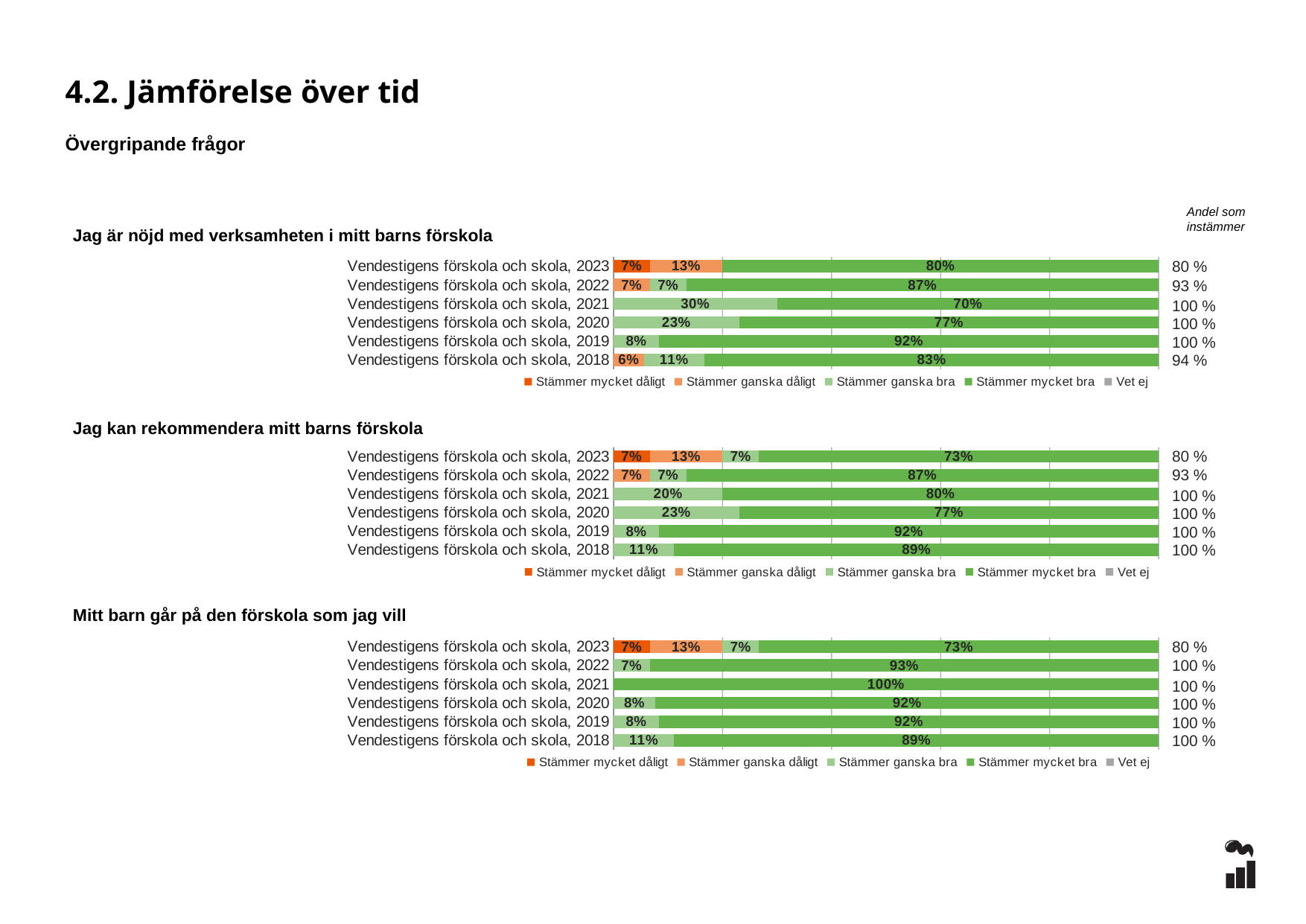
In the chart 'Jag är nöjd med verksamheten i mitt barns förskola', what is the 'Stämmer mycket bra' value for Vendestigens förskola och skola, 2023? 80% In the chart 'Mitt barn går på den förskola som jag vill', what is the 'Stämmer mycket bra' value for Vendestigens förskola och skola, 2021? 100% In the chart 'Jag kan rekommendera mitt barns förskola', what is the difference between the 'Stämmer mycket bra' values for 2019 and 2018? 3% In the chart 'Mitt barn går på den förskola som jag vill', is the 'Stämmer mycket bra' value for 2022 larger or smaller than the value for 2018? larger In the chart 'Jag är nöjd med verksamheten i mitt barns förskola', what is the 'Stämmer ganska bra' value for Vendestigens förskola och skola, 2021? 30% In the chart 'Jag kan rekommendera mitt barns förskola', what is the 'Stämmer mycket bra' value for Vendestigens förskola och skola, 2023? 73% In the chart 'Jag är nöjd med verksamheten i mitt barns förskola', what is the 'Andel som instämmer' value for 2018? 94 % What kind of chart is 'Jag kan rekommendera mitt barns förskola'? Stacked bar chart How many bars (years) are shown in the chart 'Jag är nöjd med verksamheten i mitt barns förskola'? 6 In the chart 'Jag kan rekommendera mitt barns förskola', which year has the lowest 'Stämmer mycket bra' value? 2023 In the chart 'Jag är nöjd med verksamheten i mitt barns förskola', which year has the highest 'Stämmer mycket bra' value? 2019 How many series does the legend list in the chart 'Mitt barn går på den förskola som jag vill'? 5